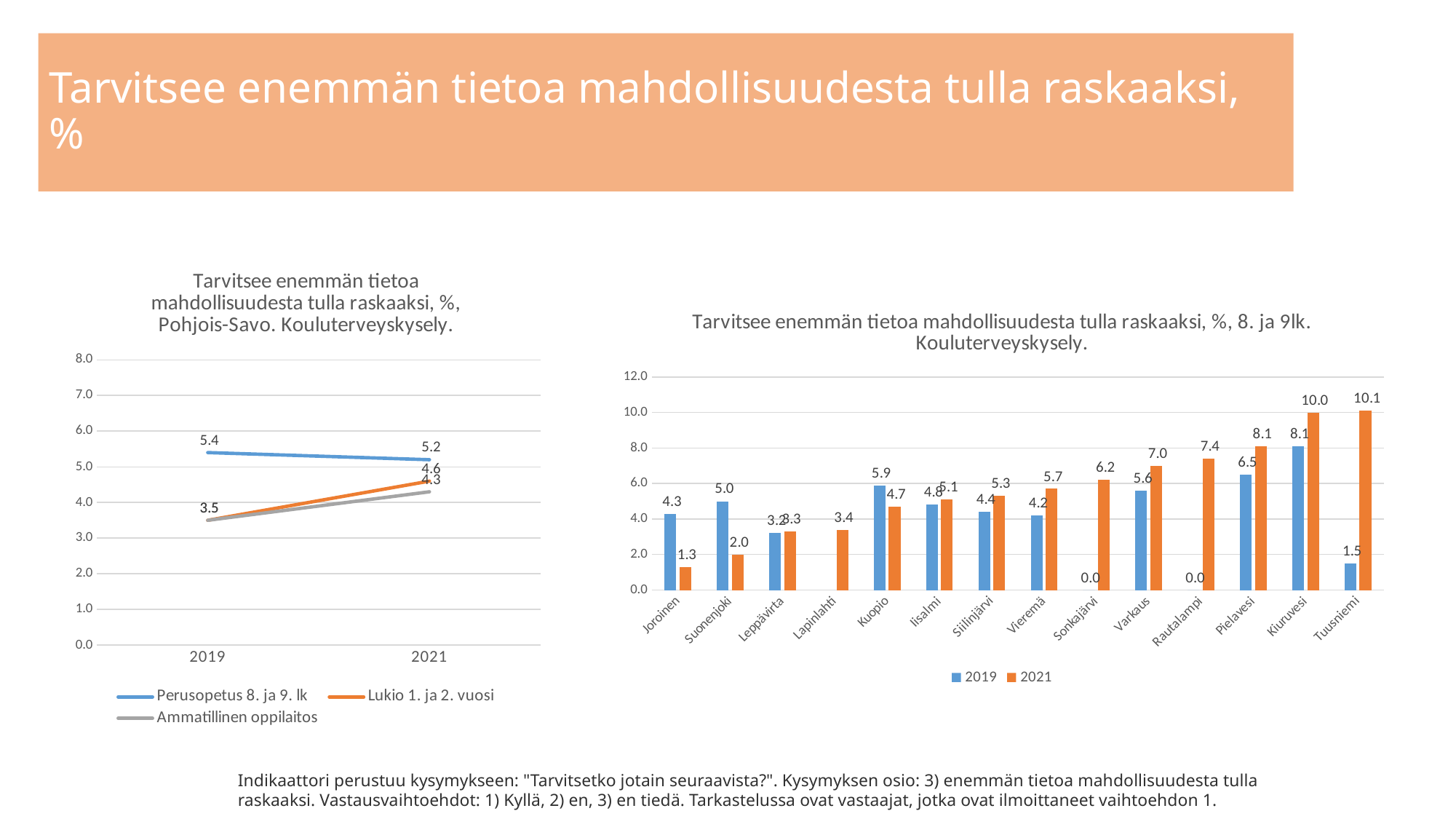
In the left chart (Pohjois-Savo), what is the value for Lukio 1. ja 2. vuosi in 2021? 4.6 In the right chart (8. ja 9lk. by municipality), which municipality has the highest 2019 value? Kiuruvesi In the right chart (8. ja 9lk. by municipality), what is the difference between the 2021 and 2019 values for Kuopio? 1.2 In the right chart (8. ja 9lk. by municipality), what is the 2021 value for Tuusniemi? 10.1 What kind of chart is the right chart (8. ja 9lk. by municipality)? bar chart In the left chart (Pohjois-Savo), what is the value for Perusopetus 8. ja 9. lk in 2019? 5.4 In the left chart (Pohjois-Savo), how many series does the legend list? 3 In the left chart (Pohjois-Savo), what is the difference between the Ammatillinen oppilaitos values in 2021 and 2019? 0.8 In the right chart (8. ja 9lk. by municipality), which is larger for Varkaus, the 2019 value or the 2021 value? 2021 In the left chart (Pohjois-Savo), does the value for Perusopetus 8. ja 9. lk rise or fall from 2019 to 2021? fall In the right chart (8. ja 9lk. by municipality), which municipality has the lowest 2021 value? Joroinen In the right chart (8. ja 9lk. by municipality), how many municipalities are shown on the x axis? 14